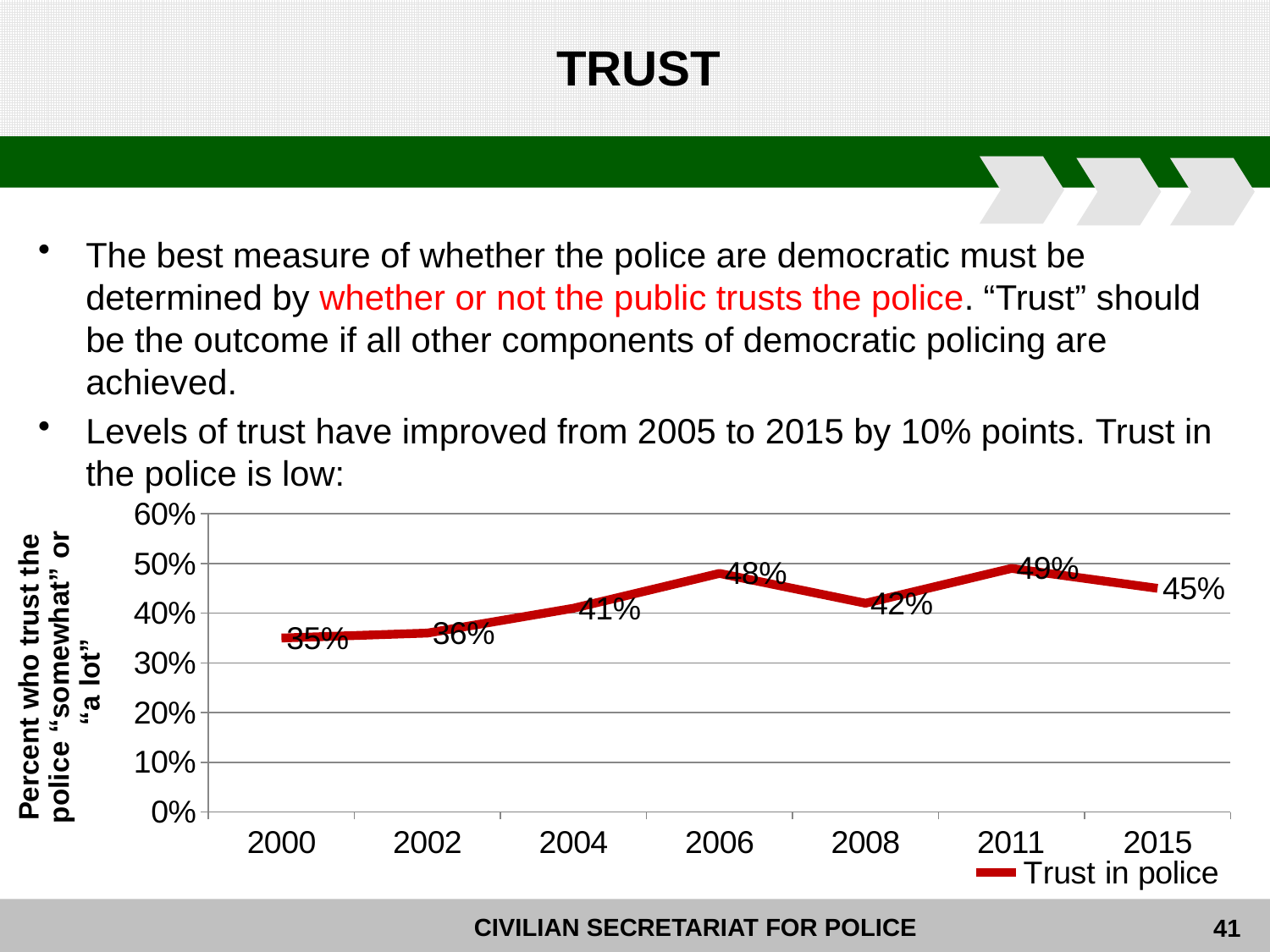
Which year has the highest value for Trust in police? 2011 What is the value for Trust in police in 2000? 35% Is the value for Trust in police in 2002 greater or less than 40%? less Which is larger, the Trust in police value for 2004 or for 2008? 2008 How many series does the legend list? 1 What is the label of the series shown in the legend? Trust in police How many years are plotted on the x axis? 7 What is the value for Trust in police in 2015? 45% What kind of chart is shown on the slide? line chart Which year has the lowest value for Trust in police? 2000 What is the value for Trust in police in 2006? 48% What is the difference between the Trust in police values for 2011 and 2008? 7%